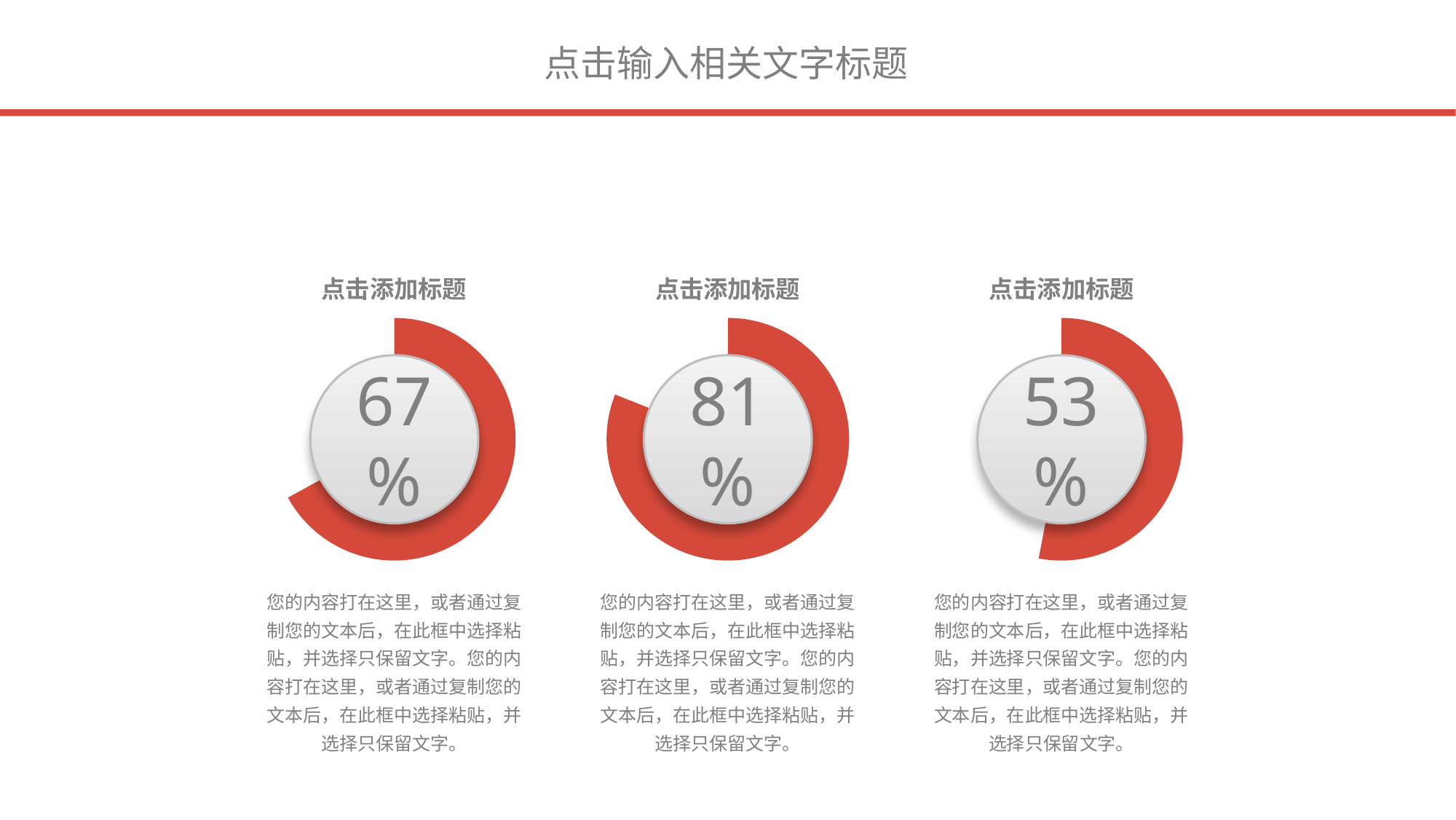
What is the difference between the percentage in the left ring chart and the percentage in the right ring chart? 14% How many ring charts are on the slide? 3 What kind of chart is used to display the percentages on the slide? ring (donut) chart What is the difference between the percentage in the middle ring chart and the percentage in the left ring chart? 14% Is the value in the middle ring chart greater or less than 80%? greater What colour is the filled arc in each ring chart? red Which of the three ring charts shows the lowest percentage: left, middle, or right? right What value is shown in the right ring chart? 53% Which of the three ring charts shows the highest percentage: left, middle, or right? middle What value is shown in the left ring chart? 67% Which is larger, the value in the left ring chart or the value in the right ring chart? left What value is shown in the middle ring chart? 81%